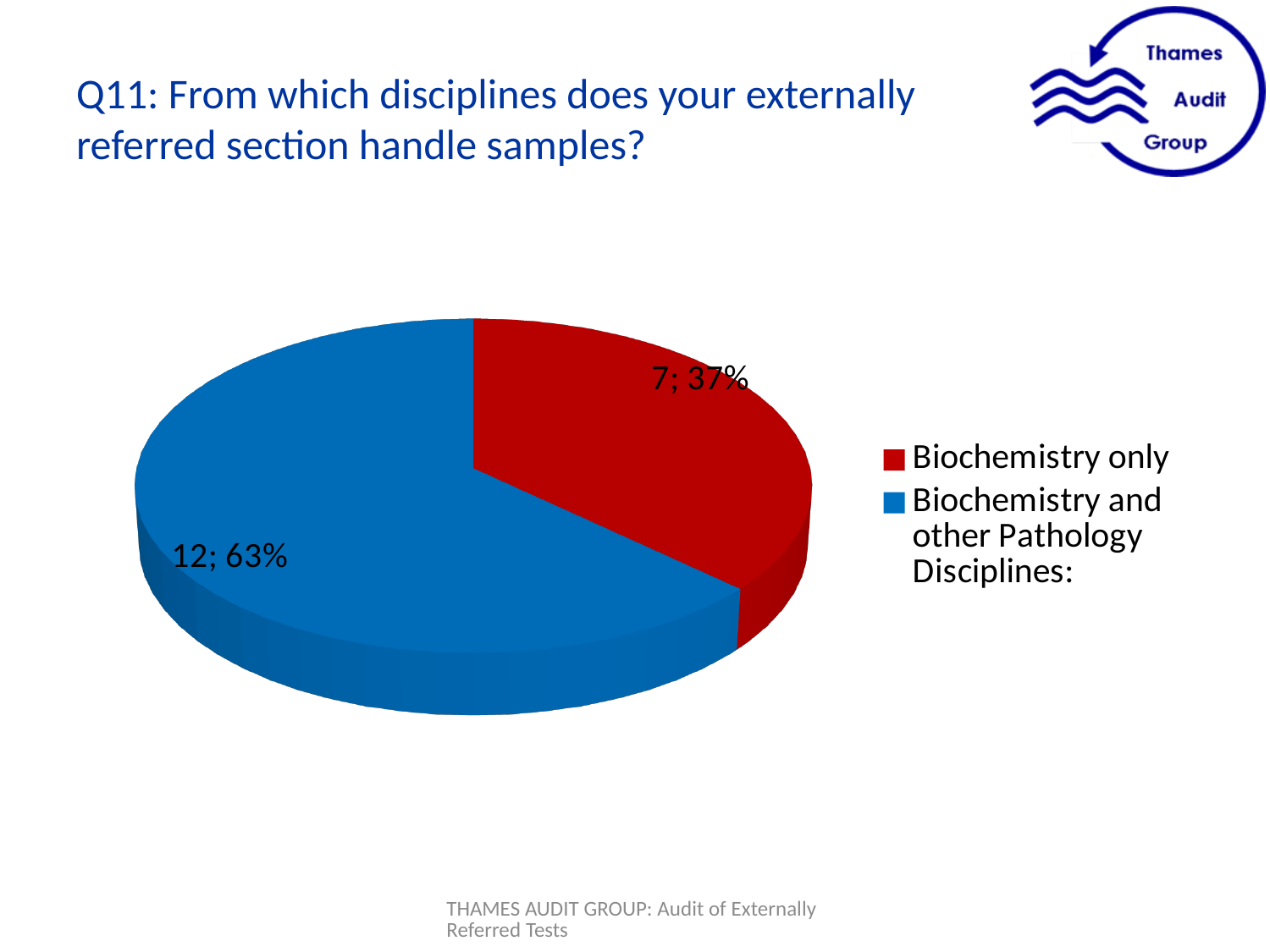
What share of the pie does 'Biochemistry and other Pathology Disciplines:' represent? 63% What share of the pie does 'Biochemistry only' represent? 37% What is the count for 'Biochemistry and other Pathology Disciplines:'? 12 How many entries does the legend list? 2 What is the count for 'Biochemistry only'? 7 Which is larger: the count for 'Biochemistry only' or for 'Biochemistry and other Pathology Disciplines:'? Biochemistry and other Pathology Disciplines: What colour is the 'Biochemistry only' slice? red How many slices does the pie chart have? 2 Which category has the largest slice? Biochemistry and other Pathology Disciplines: Which category has the smallest slice? Biochemistry only What is the difference in count between 'Biochemistry and other Pathology Disciplines:' and 'Biochemistry only'? 5 What kind of chart is shown on the slide? pie chart